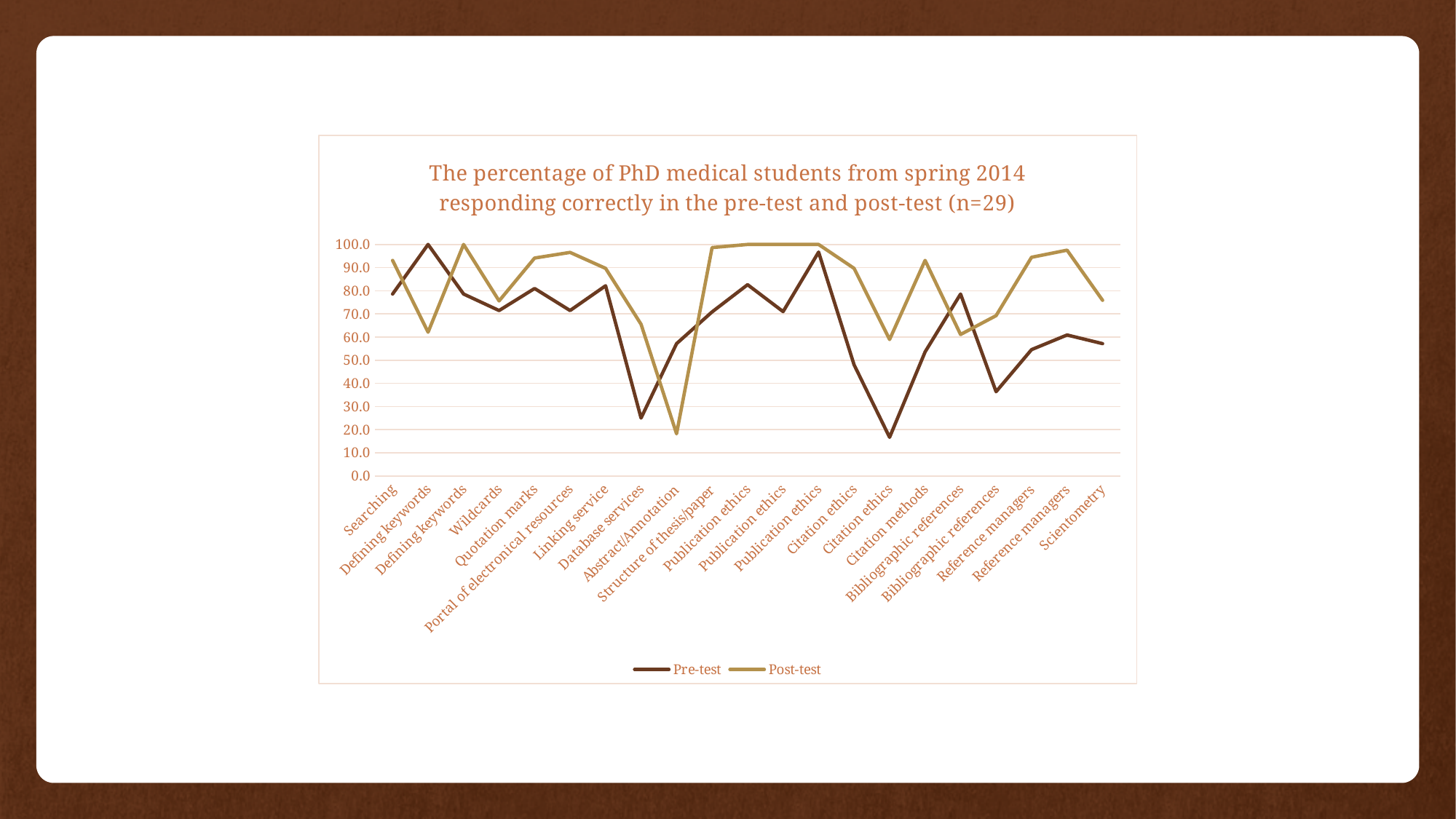
How many series does the legend list? 2 Is the Post-test value for Scientometry greater or less than 70.0? greater Is the Pre-test value for Database services greater or less than 30.0? less Which series has the higher value for Scientometry, Pre-test or Post-test? Post-test Which series has the higher value for Searching, Pre-test or Post-test? Post-test What kind of chart is shown on the slide? line chart Is the Post-test value for Abstract/Annotation greater or less than 30.0? less How many categories are plotted along the x axis? 21 Which series has the higher value for Abstract/Annotation, Pre-test or Post-test? Pre-test What are the two series named in the legend? Pre-test and Post-test At which category does the Post-test series reach its lowest value? Abstract/Annotation